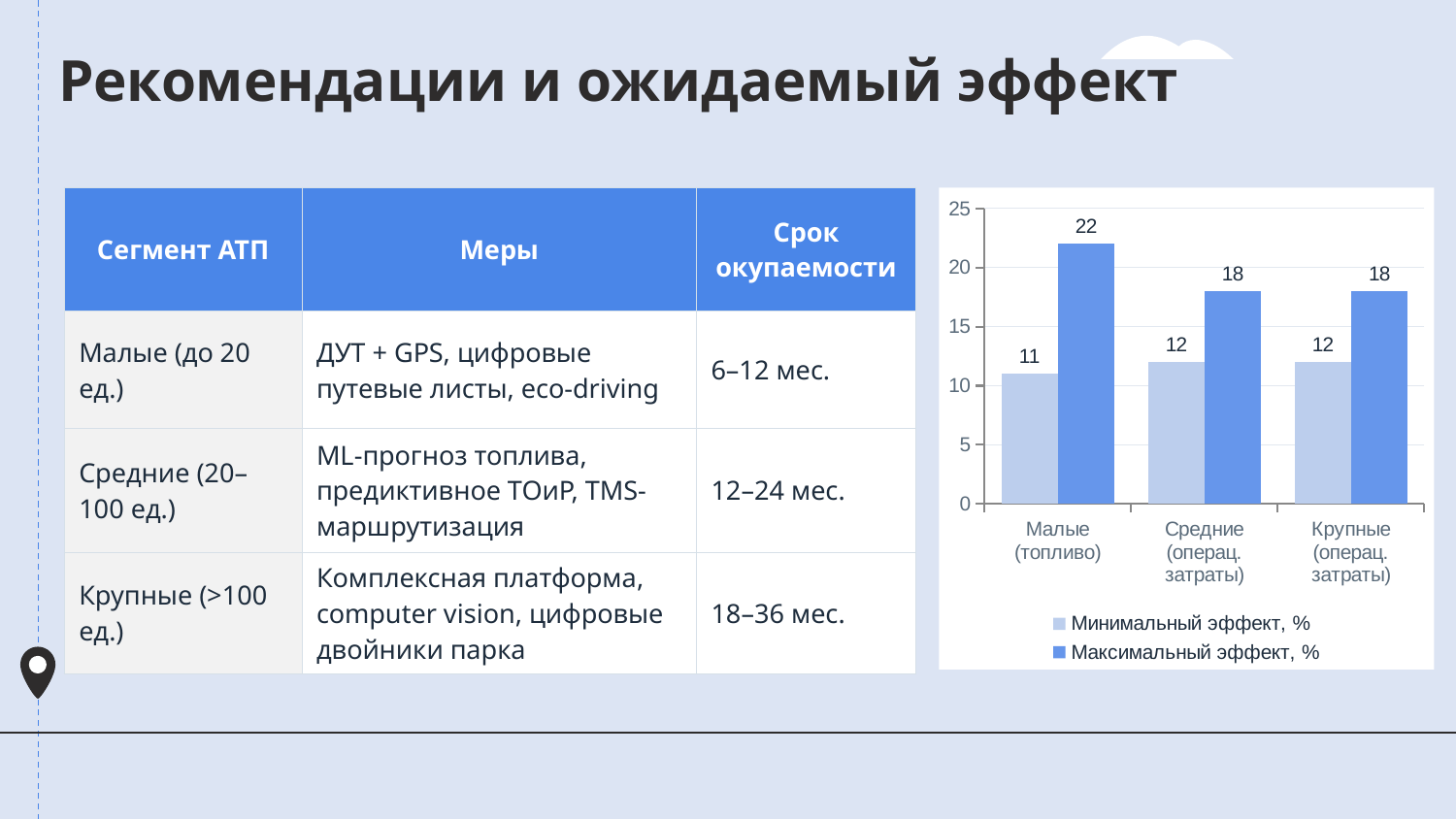
Какие ряды данных перечислены в легенде диаграммы? Минимальный эффект, %; Максимальный эффект, % На сколько максимальный эффект для сегмента «Малые (топливо)» больше минимального? 11 У какого сегмента самый высокий максимальный эффект? Малые (топливо) Какое значение максимального эффекта для сегмента «Малые (топливо)»? 22 Какое значение минимального эффекта для сегмента «Крупные (операц. затраты)»? 12 Что больше: максимальный эффект для «Малые (топливо)» или для «Средние (операц. затраты)»? Малые (топливо) Какого типа эта диаграмма? Столбчатая (bar chart) Сколько рядов данных перечислено в легенде диаграммы? 2 У какого сегмента самый низкий минимальный эффект? Малые (топливо) Сколько сегментов (категорий) показано на диаграмме? 3 Какое значение минимального эффекта для сегмента «Малые (топливо)»? 11 Какое значение максимального эффекта для сегмента «Средние (операц. затраты)»? 18